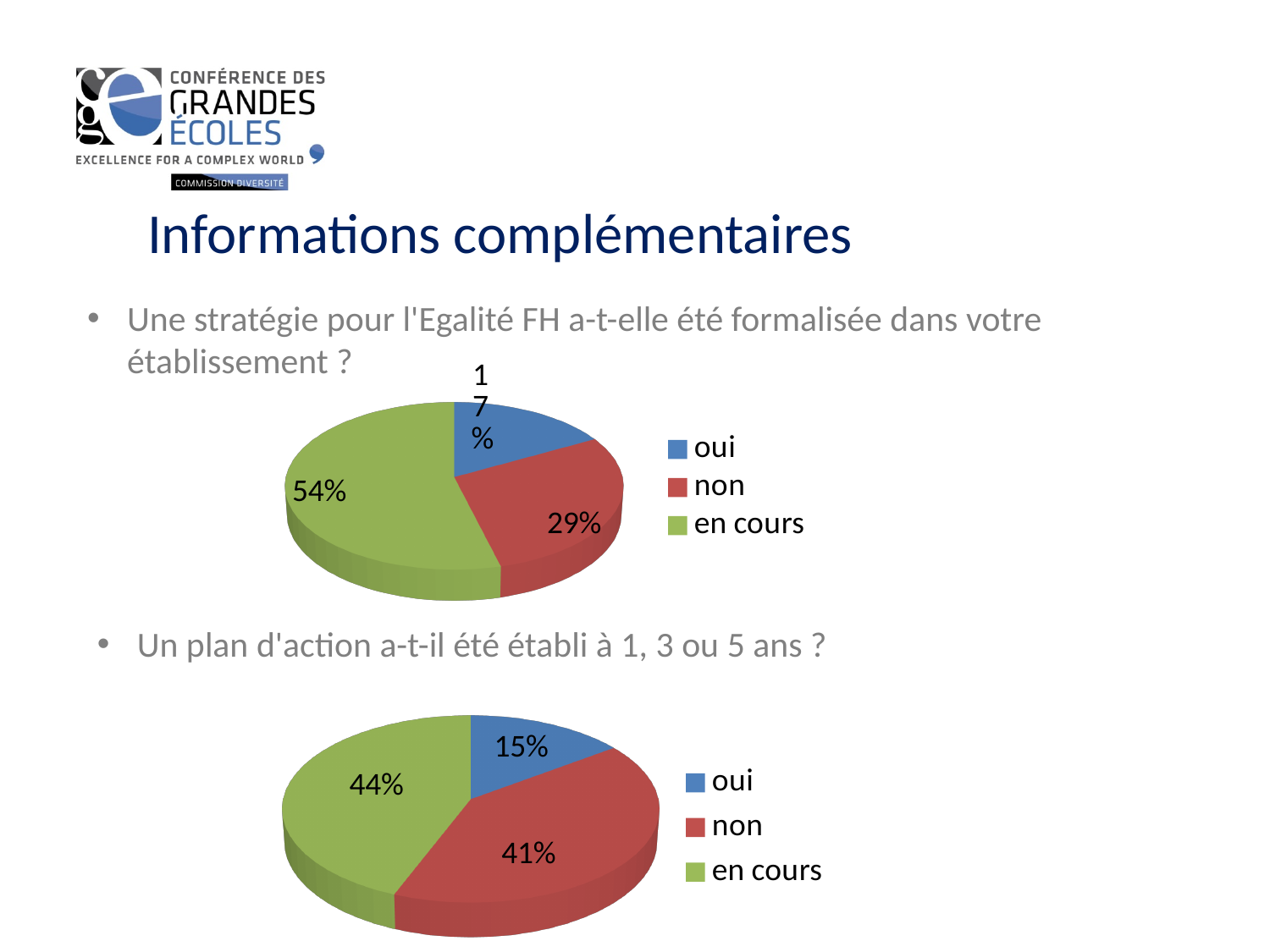
In the top pie chart (stratégie pour l'Egalité FH), which category has the smallest slice? oui In the top pie chart (stratégie pour l'Egalité FH), what share is labelled for 'non'? 29% What type of chart is used for the top chart on the slide? Pie chart In the bottom pie chart (plan d'action à 1, 3 ou 5 ans), what share is labelled for 'non'? 41% In the top pie chart (stratégie pour l'Egalité FH), what is the difference in percentage points between 'en cours' and 'non'? 25 In the top pie chart (stratégie pour l'Egalité FH), what share is labelled for 'en cours'? 54% In the bottom pie chart (plan d'action à 1, 3 ou 5 ans), which is larger, 'non' or 'oui'? non In the bottom pie chart (plan d'action à 1, 3 ou 5 ans), what share is labelled for 'oui'? 15% How many categories does the legend of the bottom pie chart list? 3 In the bottom pie chart (plan d'action à 1, 3 ou 5 ans), which category has the largest slice? en cours In the top pie chart (stratégie pour l'Egalité FH), what share is labelled for 'oui'? 17% In the top pie chart (stratégie pour l'Egalité FH), which category has the largest slice? en cours